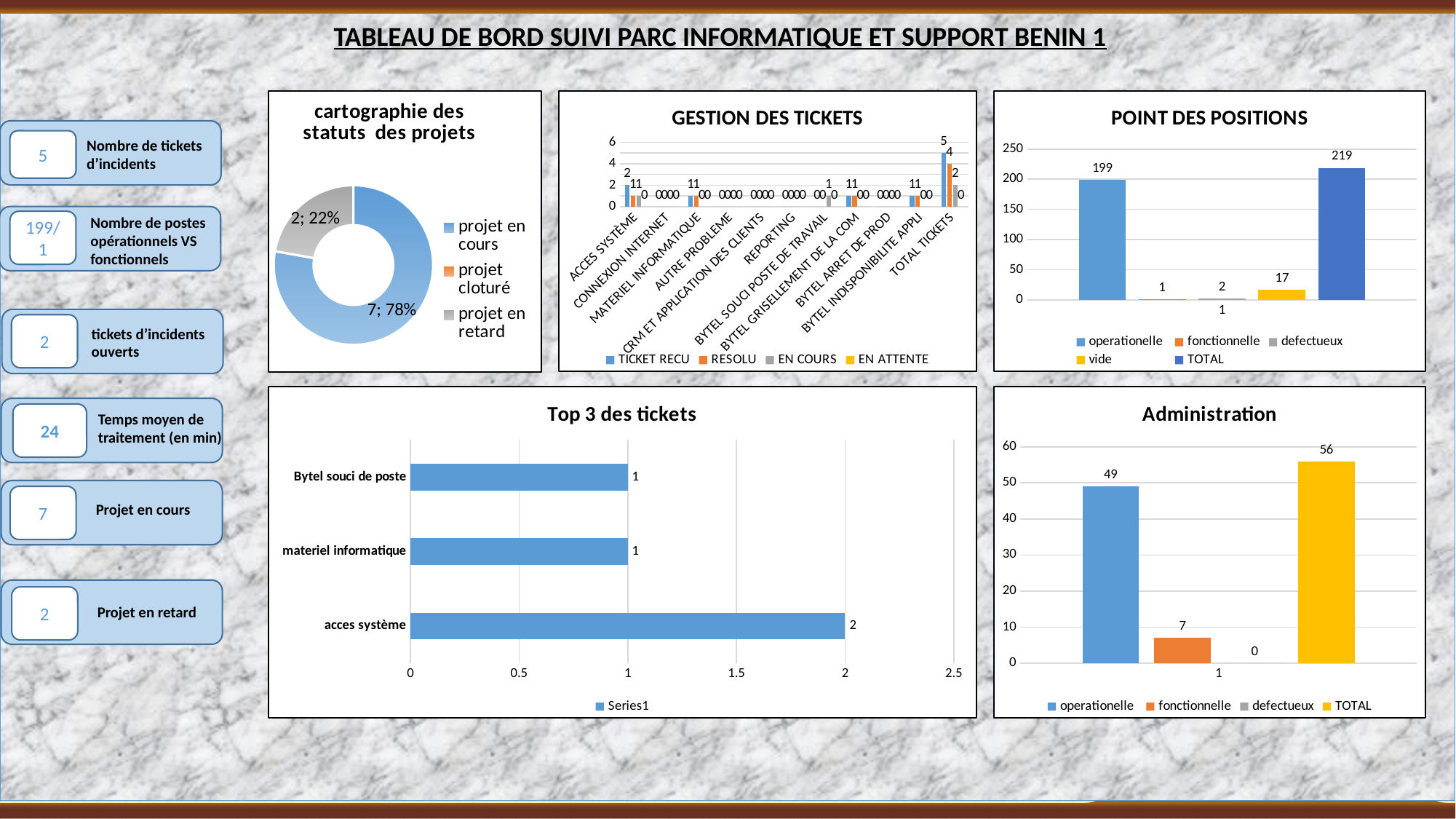
In the 'cartographie des statuts des projets' chart, what share of the doughnut is 'projet en retard'? 22% In the 'GESTION DES TICKETS' chart, how many series does the legend list? 4 In the 'Top 3 des tickets' chart, what is the value for acces système? 2 In the 'POINT DES POSITIONS' chart, what is the value for TOTAL? 219 In the 'Administration' chart, what is the value for fonctionnelle? 7 In the 'Administration' chart, which category has the lowest value? defectueux In the 'GESTION DES TICKETS' chart, what is the TICKET RECU value for TOTAL TICKETS? 5 In the 'POINT DES POSITIONS' chart, what is the value for operationelle? 199 In the 'Top 3 des tickets' chart, how many categories are shown? 3 What kind of chart is 'Top 3 des tickets'? bar chart In the 'Administration' chart, how many series does the legend list? 4 In the 'POINT DES POSITIONS' chart, what is the difference between the TOTAL value and the operationelle value? 20